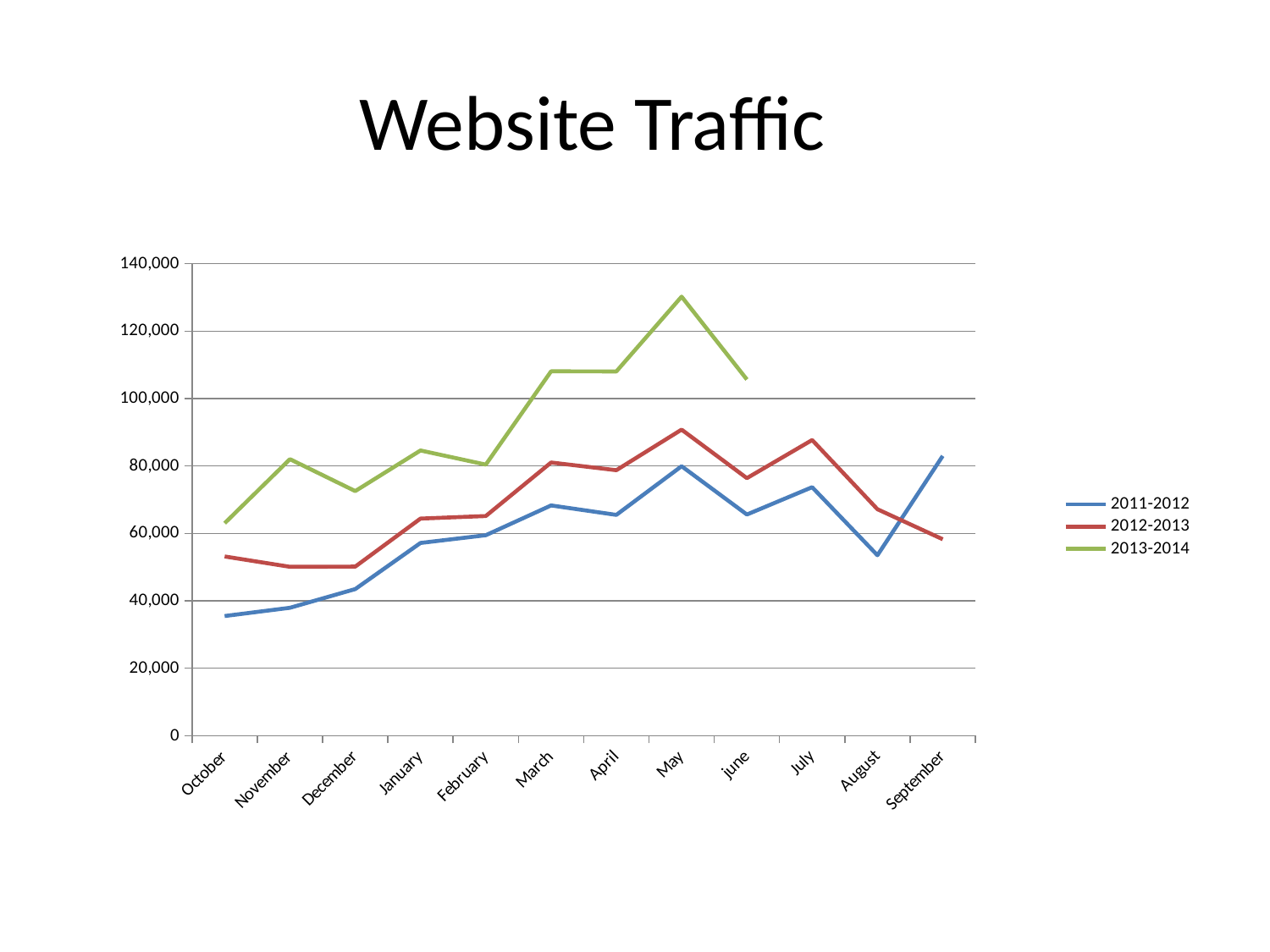
How many series does the legend list? 3 Which series in the legend is drawn in green? 2013-2014 How many months are shown along the x axis? 12 Is the value for 2011-2012 in October greater or less than 40,000? less In September, which series has the larger value, 2011-2012 or 2012-2013? 2011-2012 Does the 2013-2014 series rise or fall from May to June? Fall What is the title of the chart? Website Traffic In which month does the 2011-2012 series have its lowest value? October Is the value for 2011-2012 in August greater or less than 60,000? less Is the value for 2013-2014 in May greater or less than 120,000? greater In which month does the 2013-2014 series reach its highest value? May What kind of chart is shown on the slide? Line chart